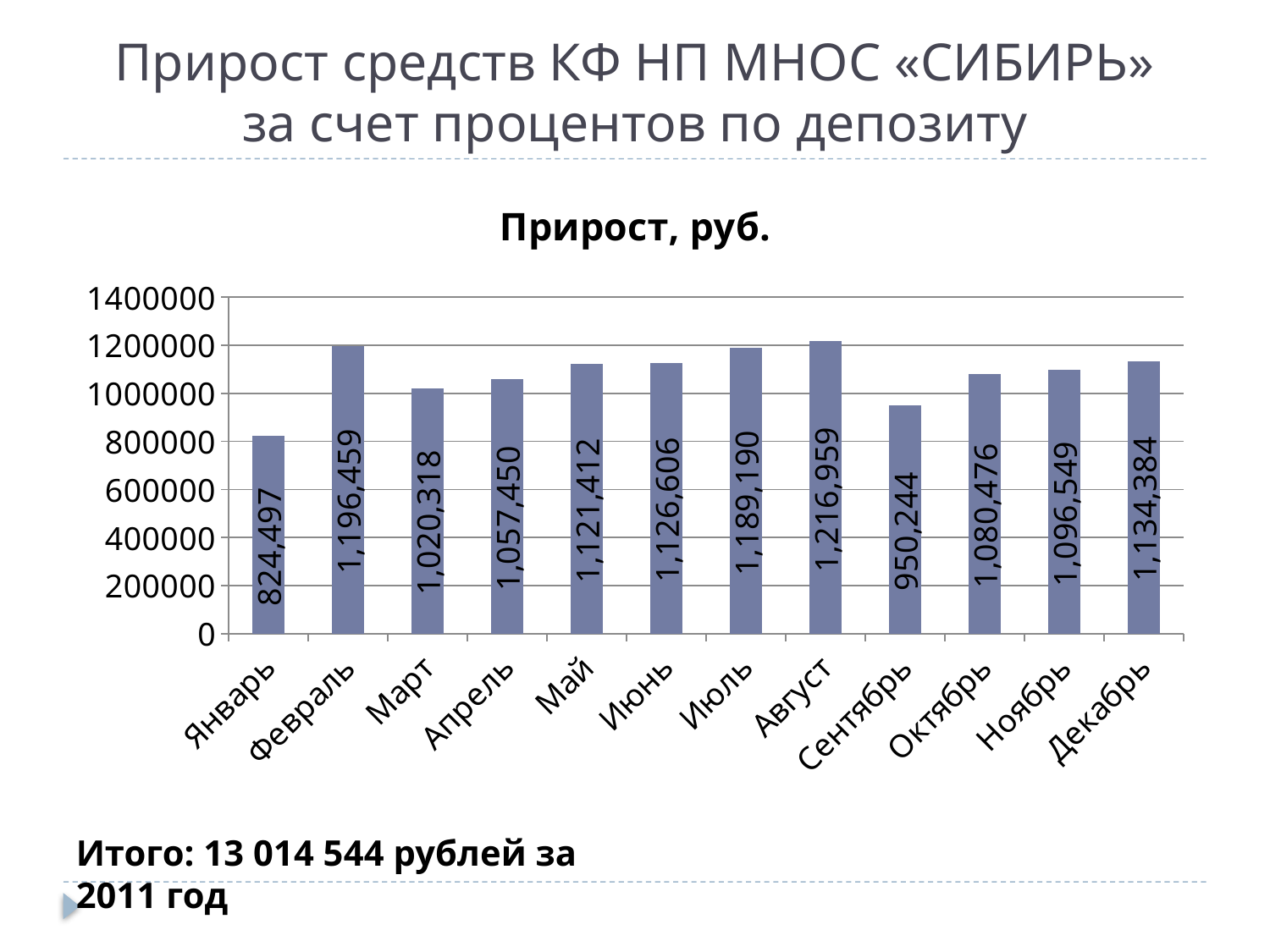
What is the value for Январь? 824,497 What is the difference between the values for Август and Январь? 392,462 How many months are shown on the x axis? 12 What is the difference between the values for Февраль and Март? 176,141 Which month has the highest value? Август What is the title of the chart? Прирост, руб. What kind of chart is shown on the slide? bar chart What is the value for Август? 1,216,959 Which month has the lowest value? Январь What is the value for Сентябрь? 950,244 Is the value for Сентябрь greater or less than 1000000? less Which is larger, the value for Июль or the value for Декабрь? Июль